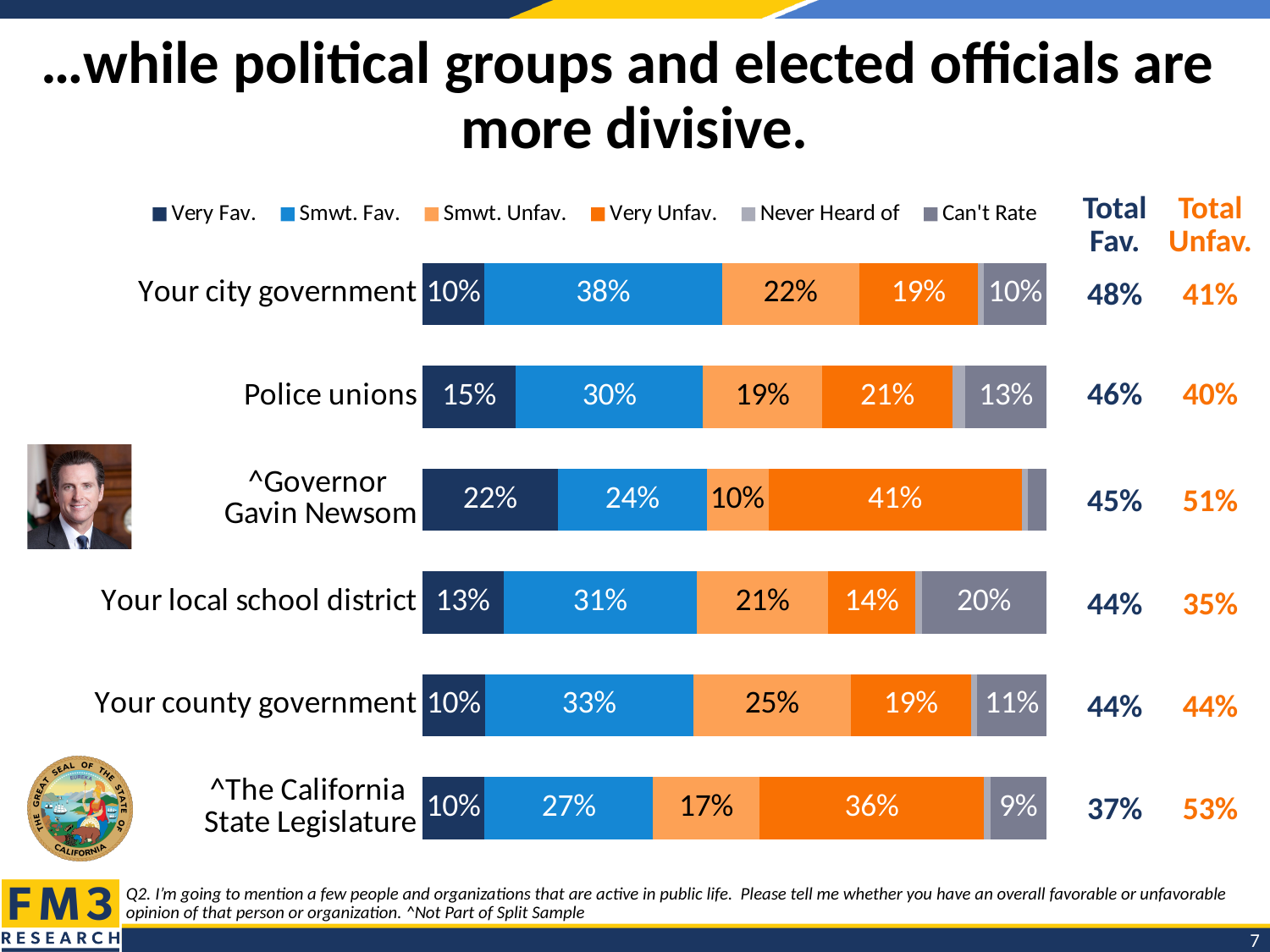
How many categories (people or organizations) are shown in the chart? 6 What is the Total Favorable value for Police unions? 46% Which category has the highest Very Favorable value? Governor Gavin Newsom What is the Somewhat Favorable (Smwt. Fav.) value for Your city government? 38% What kind of chart is shown on the slide? Stacked bar chart Which has a larger Very Unfavorable value: Governor Gavin Newsom or The California State Legislature? Governor Gavin Newsom What is the Total Unfavorable value for The California State Legislature? 53% How many series does the legend list? 6 Which category has the highest Total Favorable value? Your city government Which category has the lowest Total Favorable value? The California State Legislature What percentage of respondents have a Very Unfavorable opinion of Governor Gavin Newsom? 41% For The California State Legislature, how many percentage points higher is Total Unfavorable than Total Favorable? 16 percentage points